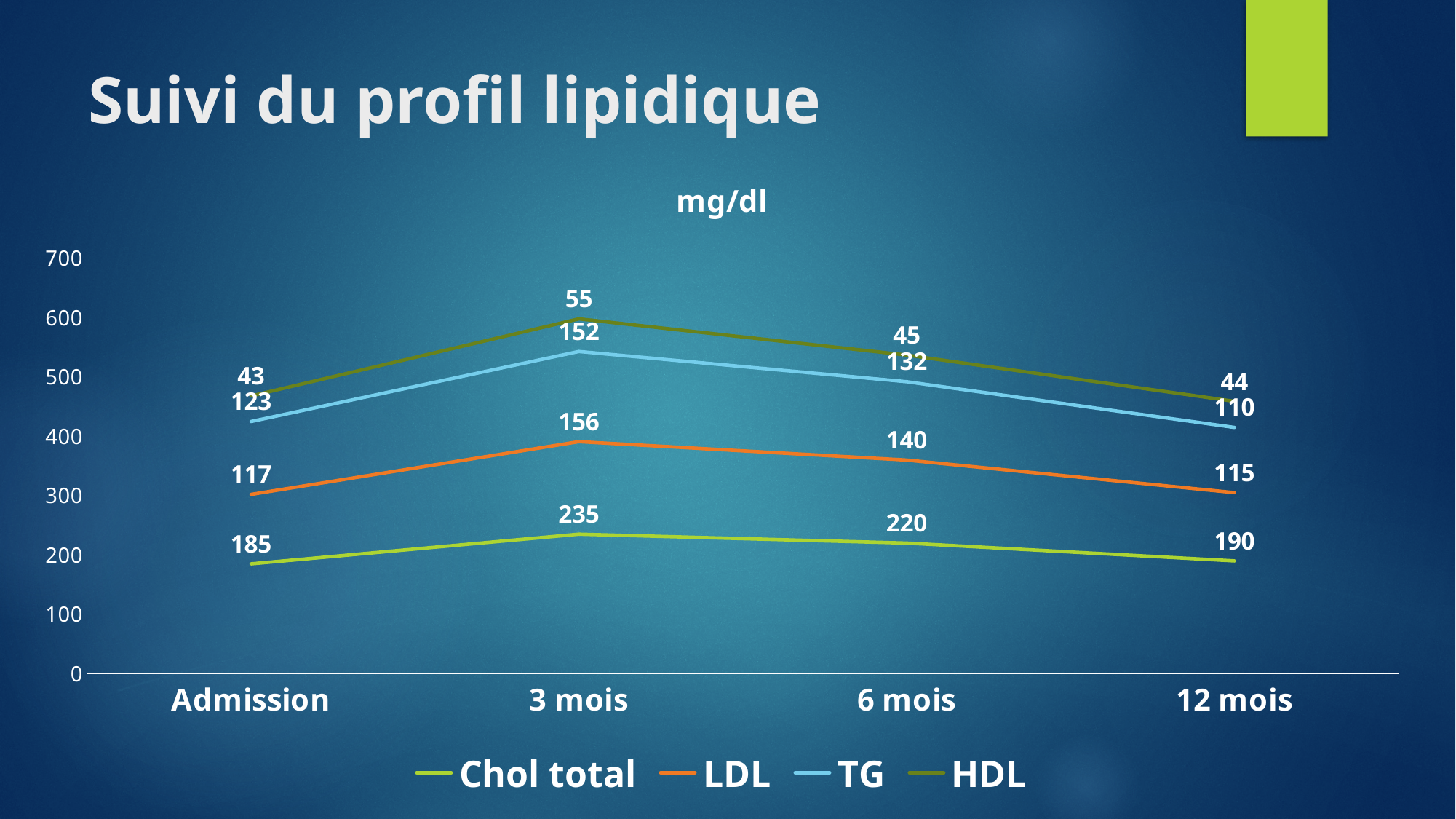
What is the LDL value at Admission? 117 What is the HDL value at 6 mois? 45 How many series does the legend list? 4 How many time points are shown on the x axis? 4 At which time point is TG lowest? 12 mois At which time point is Chol total highest? 3 mois What is the TG value at 12 mois? 110 Which is larger, the Chol total value at 6 mois or at 12 mois? 6 mois What is the difference between the LDL value at 3 mois and at 12 mois? 41 What unit is given in the chart title? mg/dl What is the Chol total value at 3 mois? 235 What kind of chart is shown on the slide? line chart